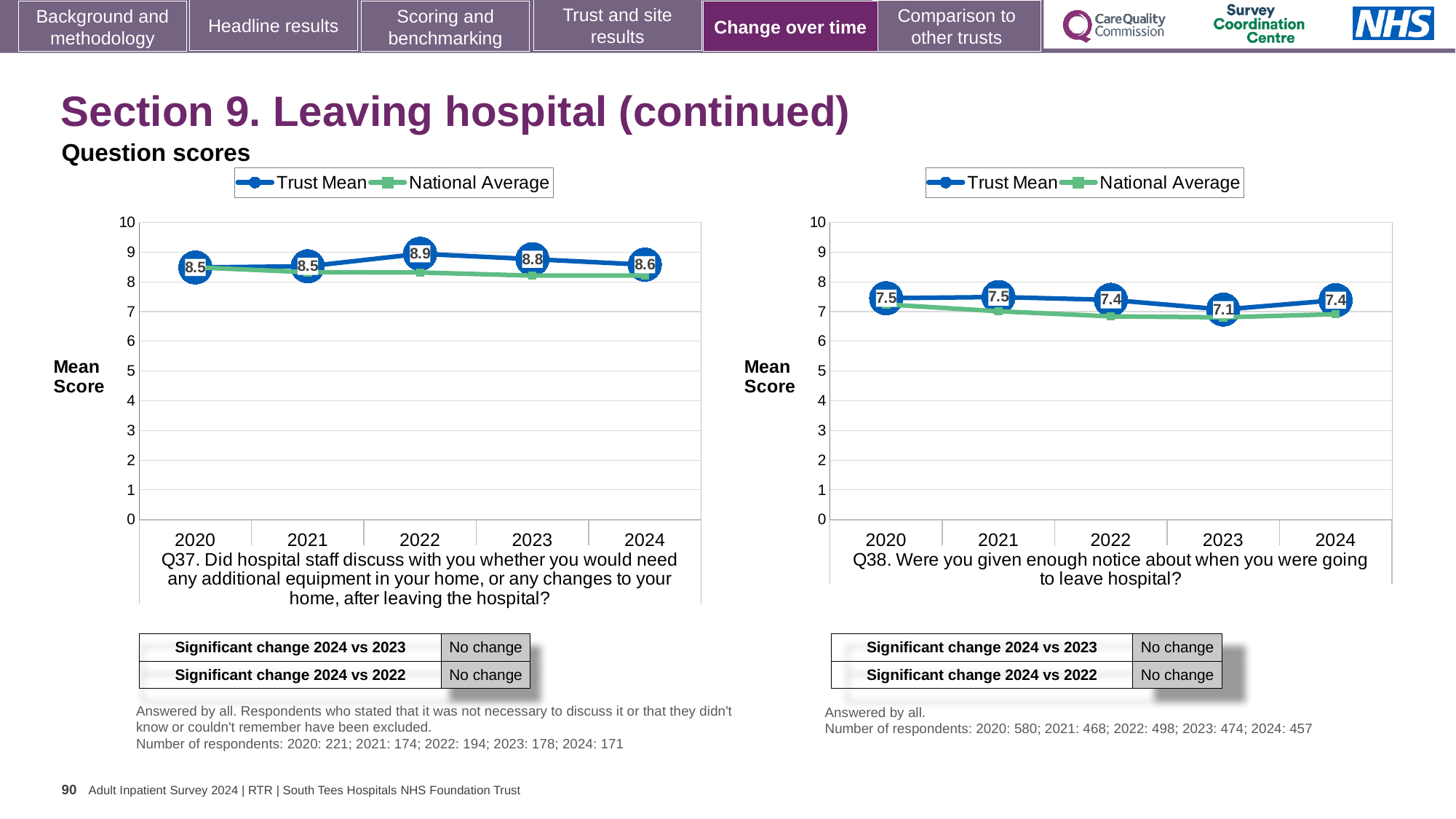
In the Q37 chart on the left, what is the Trust Mean score for 2024? 8.6 In the Q38 chart on the right, what is the Trust Mean score for 2020? 7.5 In the Q37 chart on the left, which year has the highest Trust Mean score? 2022 What type of chart is used for the Q37 chart on the left? Line chart How many years are plotted on the x axis of the Q37 chart on the left? 5 How many series does the legend of the Q38 chart on the right list? 2 In the Q37 chart on the left, what is the difference between the Trust Mean scores for 2022 and 2020? 0.4 In the Q37 chart on the left, what is the Trust Mean score for 2022? 8.9 In the Q38 chart on the right, what is the Trust Mean score for 2023? 7.1 In the Q38 chart on the right, which year has the lowest Trust Mean score? 2023 In the Q38 chart on the right, is the Trust Mean score for 2024 greater or less than 8? less In the Q38 chart on the right, is the Trust Mean for 2022 larger or smaller than the Trust Mean for 2023? larger